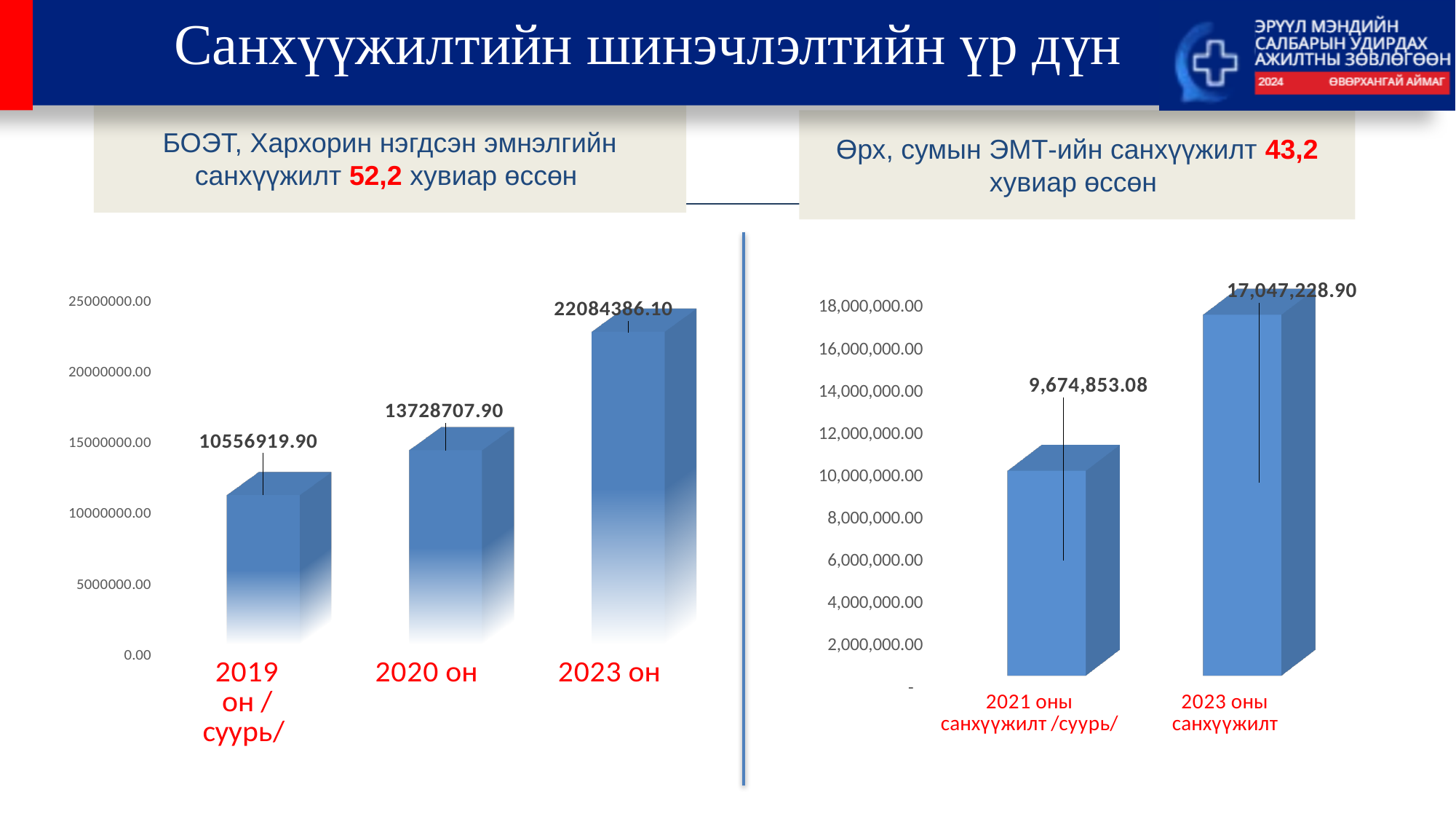
In the left chart (БОЭТ, Хархорин нэгдсэн эмнэлгийн санхүүжилт), which year has the highest value? 2023 он In the left chart (БОЭТ, Хархорин нэгдсэн эмнэлгийн санхүүжилт), what is the value for 2023 он? 22084386.10 In the left chart (БОЭТ, Хархорин нэгдсэн эмнэлгийн санхүүжилт), what is the difference between the 2023 он and 2019 он /суурь/ values? 11527466.20 In the right chart (Өрх, сумын ЭМТ-ийн санхүүжилт), what is the value for 2021 оны санхүүжилт /суурь/? 9,674,853.08 In the left chart (БОЭТ, Хархорин нэгдсэн эмнэлгийн санхүүжилт), how many bars are plotted? 3 In the left chart (БОЭТ, Хархорин нэгдсэн эмнэлгийн санхүүжилт), what is the value for 2019 он /суурь/? 10556919.90 In the left chart (БОЭТ, Хархорин нэгдсэн эмнэлгийн санхүүжилт), what is the value for 2020 он? 13728707.90 In the right chart (Өрх, сумын ЭМТ-ийн санхүүжилт), what is the value for 2023 оны санхүүжилт? 17,047,228.90 In the right chart (Өрх, сумын ЭМТ-ийн санхүүжилт), what is the difference between the 2023 оны санхүүжилт and 2021 оны санхүүжилт /суурь/ values? 7,372,375.82 What kind of chart is the right chart (Өрх, сумын ЭМТ-ийн санхүүжилт)? bar chart In the left chart (БОЭТ, Хархорин нэгдсэн эмнэлгийн санхүүжилт), do the values rise or fall from 2019 to 2023? rise In the right chart (Өрх, сумын ЭМТ-ийн санхүүжилт), which category has the lower value? 2021 оны санхүүжилт /суурь/